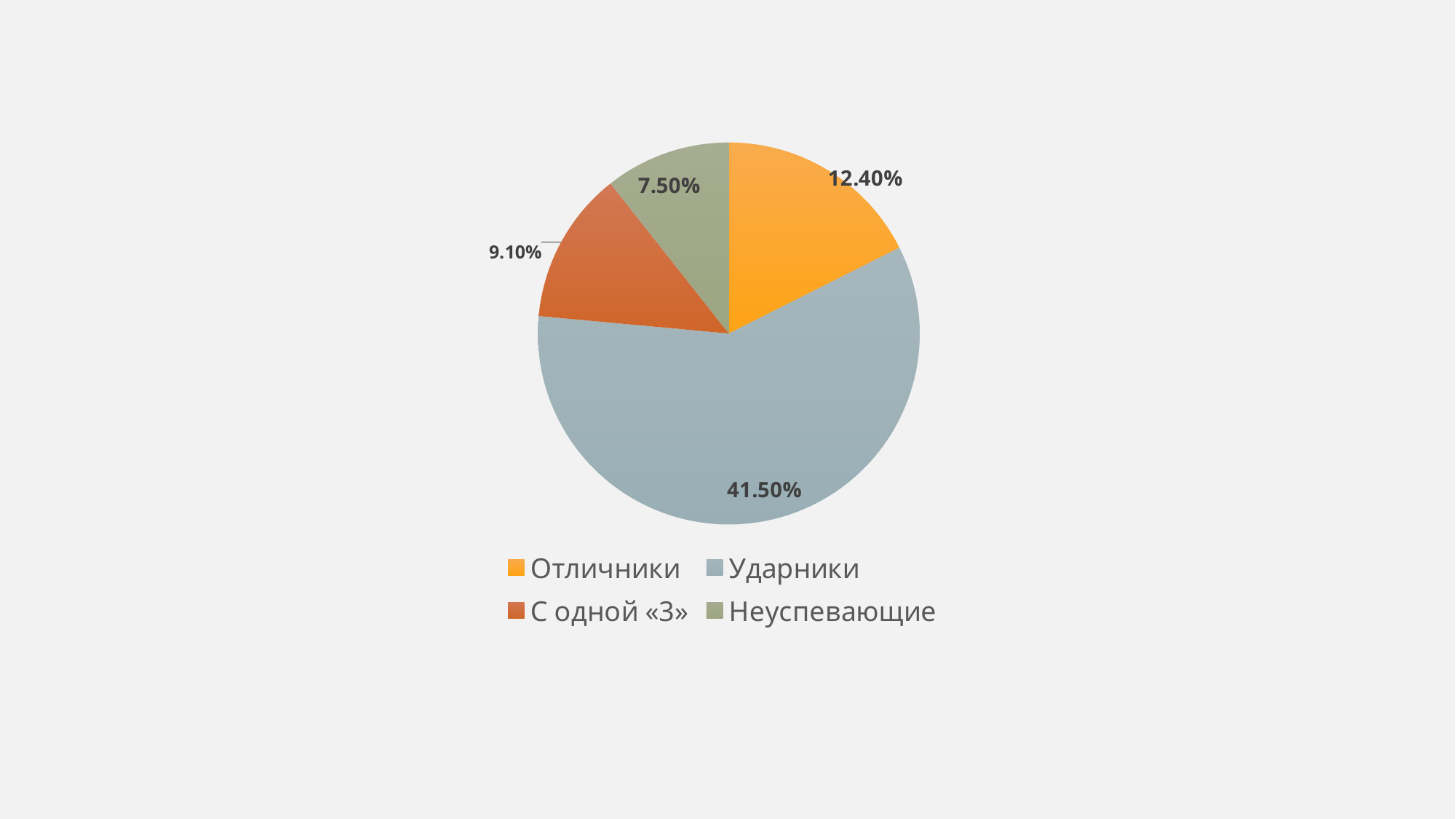
What is the difference between the values for Ударники and Отличники? 29.10% What value is shown for Ударники? 41.50% What is the difference between the values for С одной «3» and Неуспевающие? 1.60% Which is larger, the value for Отличники or the value for С одной «3»? Отличники Which category has the smallest slice of the pie? Неуспевающие What value is shown for Отличники? 12.40% What kind of chart is shown on the slide? pie chart How many categories does the pie chart show? 4 What value is shown for Неуспевающие? 7.50% What value is shown for С одной «3»? 9.10% What colour is the slice for Ударники? grey-blue Which category has the largest slice of the pie? Ударники